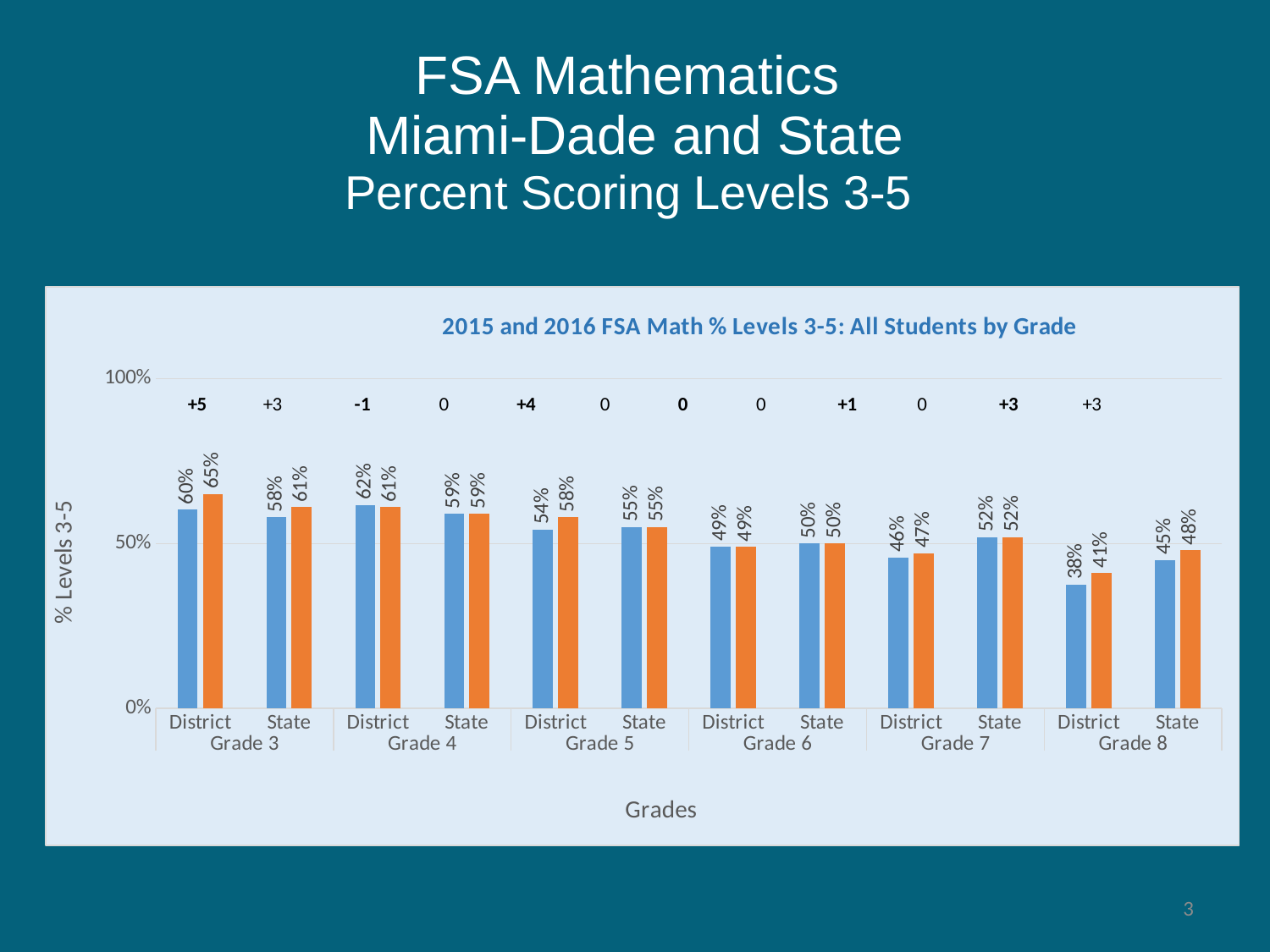
Which is larger, the orange bar for District in Grade 8 or the orange bar for State in Grade 8? State Grade 8 What change value is printed above the District bars for Grade 4? -1 Which group has the highest orange bar value? District Grade 3 What is the value of the blue bar for District in Grade 5? 54% How many District/State groups are shown along the x axis? 12 Is the blue bar for District in Grade 7 greater or less than 50%? less What kind of chart is shown? bar chart What is the value of the orange bar for District in Grade 3? 65% Which group has the lowest blue bar value? District Grade 8 What is the difference between the orange and blue bars for District in Grade 3? 5% What is the title of the chart? 2015 and 2016 FSA Math % Levels 3-5: All Students by Grade What is the value of the blue bar for State in Grade 8? 45%